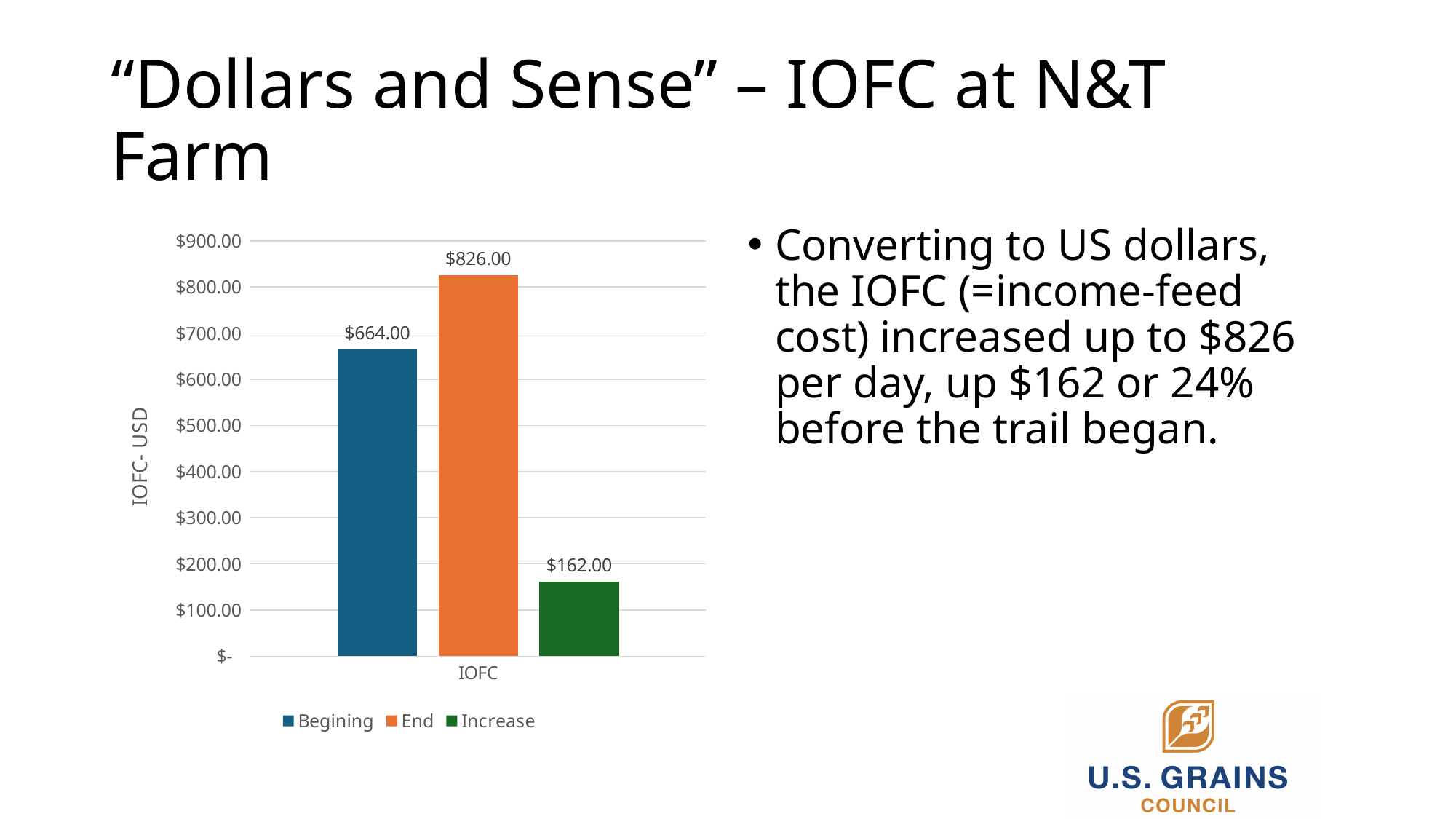
Which series has the highest value in the chart? End What is the value of the End series in the chart? $826.00 Which series has the lowest value in the chart? Increase What colour is the bar for the End series? Orange What is the difference between the End value and the Begining value? $162.00 Is the value for Begining greater or less than $600.00? greater What kind of chart is shown on the slide? Bar chart What is the label on the vertical axis of the chart? IOFC- USD How many series does the legend list? 3 Which is larger, the Begining value or the Increase value? Begining What is the value of the Increase series in the chart? $162.00 What is the value of the Begining series in the chart? $664.00